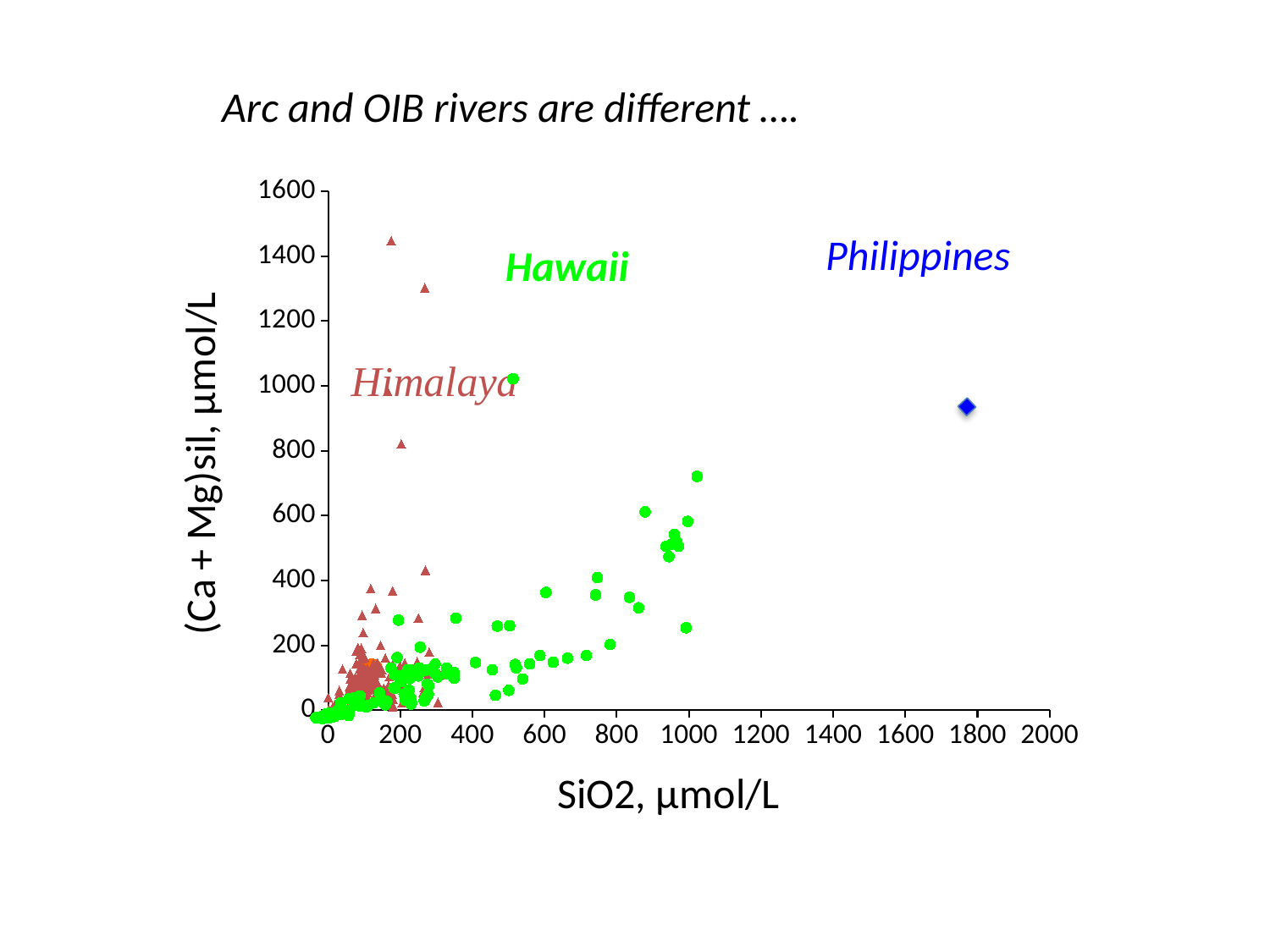
Is the (Ca + Mg)sil value of the Philippines point greater or less than 1000? less Which river group is plotted with a blue diamond marker? Philippines How many river groups (series) are labelled on the chart? 3 How many points are plotted for the Philippines? 1 Is the highest (Ca + Mg)sil value among the Himalaya points greater or less than 1400? greater Is the SiO2 value of the Philippines point greater or less than 1600? greater What kind of chart is shown on the slide? scatter plot Which river group has the point with the highest (Ca + Mg)sil value? Himalaya Which river group has the point with the highest SiO2 value? Philippines Which has the larger SiO2 value: the Philippines point or the Hawaii point with the highest SiO2? Philippines What is the label of the x axis? SiO2, µmol/L